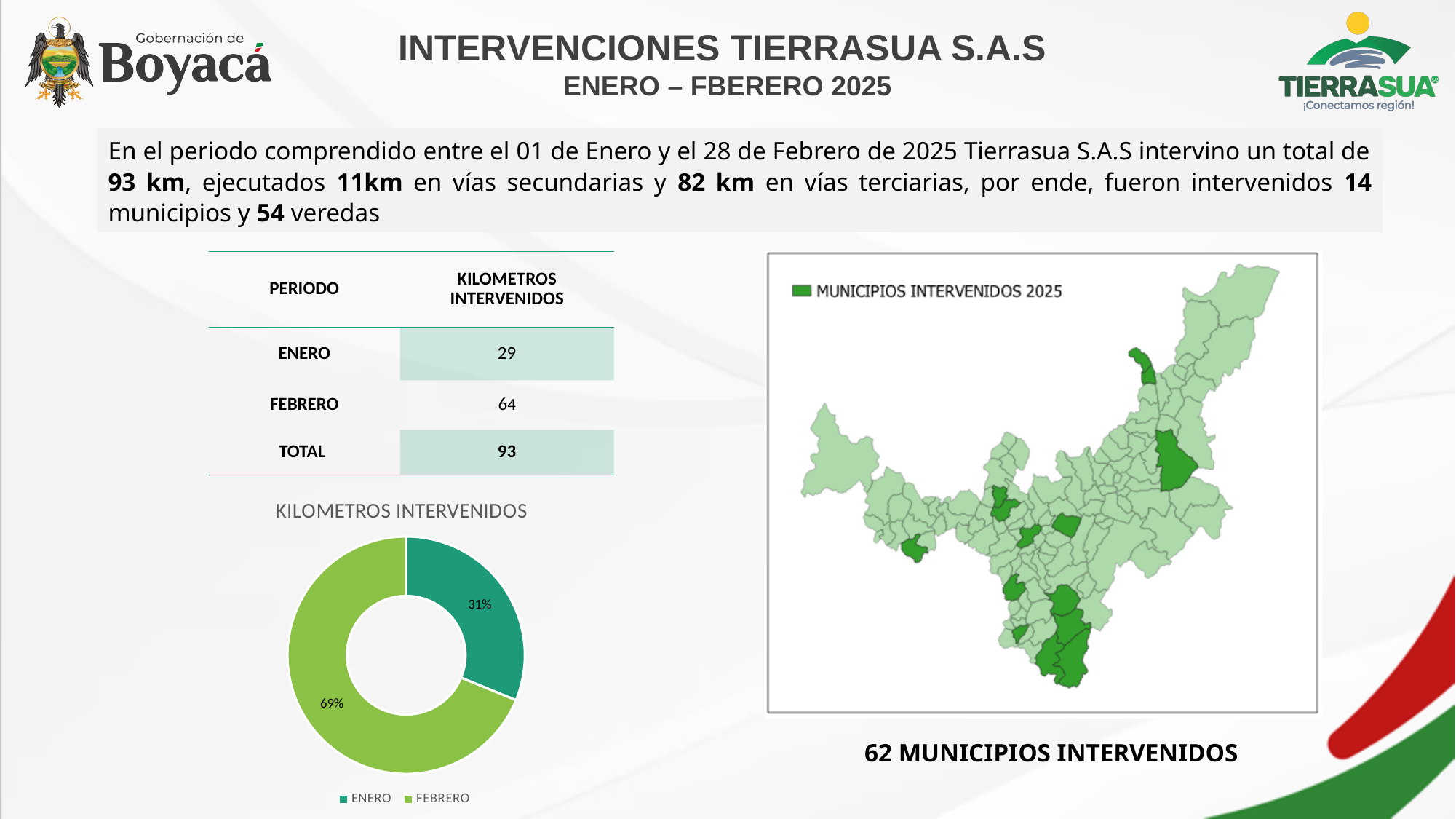
How many entries does the legend of the "KILOMETROS INTERVENIDOS" chart list? 2 Which legend entry in the "KILOMETROS INTERVENIDOS" chart is shown in the lighter green colour? FEBRERO What is the title of the doughnut chart on the slide? KILOMETROS INTERVENIDOS What kind of chart is the "KILOMETROS INTERVENIDOS" chart? doughnut (pie) chart In the "KILOMETROS INTERVENIDOS" chart, which is larger, the ENERO slice or the FEBRERO slice? FEBRERO Which slice is the smallest in the "KILOMETROS INTERVENIDOS" chart? ENERO How many slices does the "KILOMETROS INTERVENIDOS" chart have? 2 Which slice is the largest in the "KILOMETROS INTERVENIDOS" chart? FEBRERO What share of the "KILOMETROS INTERVENIDOS" chart does FEBRERO represent? 69% In the "KILOMETROS INTERVENIDOS" chart, what is the difference in percentage points between the FEBRERO and ENERO shares? 38 percentage points What share of the "KILOMETROS INTERVENIDOS" chart does ENERO represent? 31% Is the ENERO share in the "KILOMETROS INTERVENIDOS" chart greater or less than 50%? less